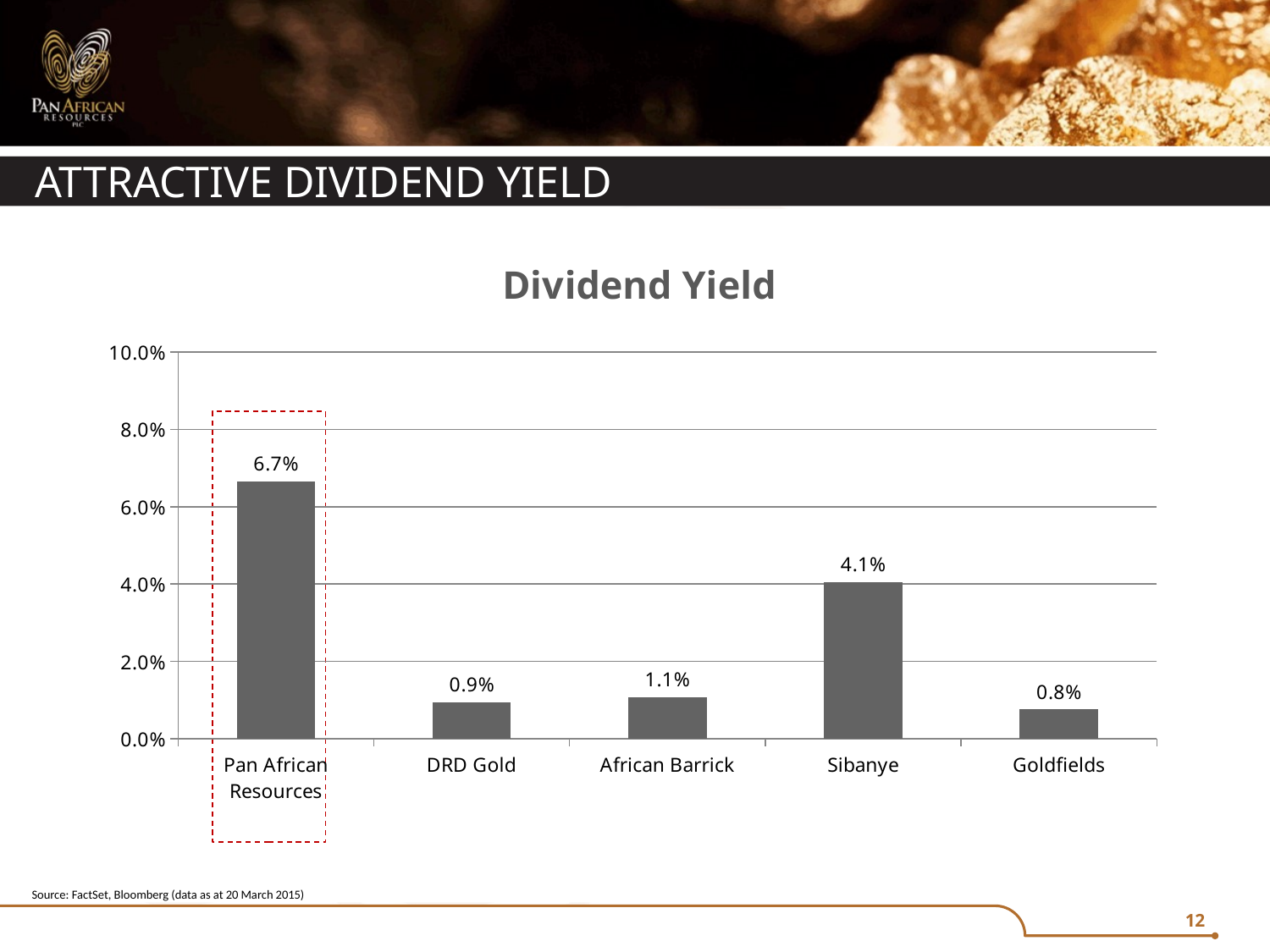
Which has a higher dividend yield, African Barrick or DRD Gold? African Barrick Which company has the highest dividend yield? Pan African Resources What is the dividend yield for Sibanye? 4.1% What is the title of the chart? Dividend Yield Is the dividend yield for Sibanye greater or less than 6.0%? less Which company has the lowest dividend yield? Goldfields What is the dividend yield for Pan African Resources? 6.7% What is the dividend yield for Goldfields? 0.8% What is the dividend yield for DRD Gold? 0.9% How many companies are shown in the chart? 5 What is the difference in dividend yield between Pan African Resources and Sibanye? 2.6% What type of chart is shown on the slide? Bar chart